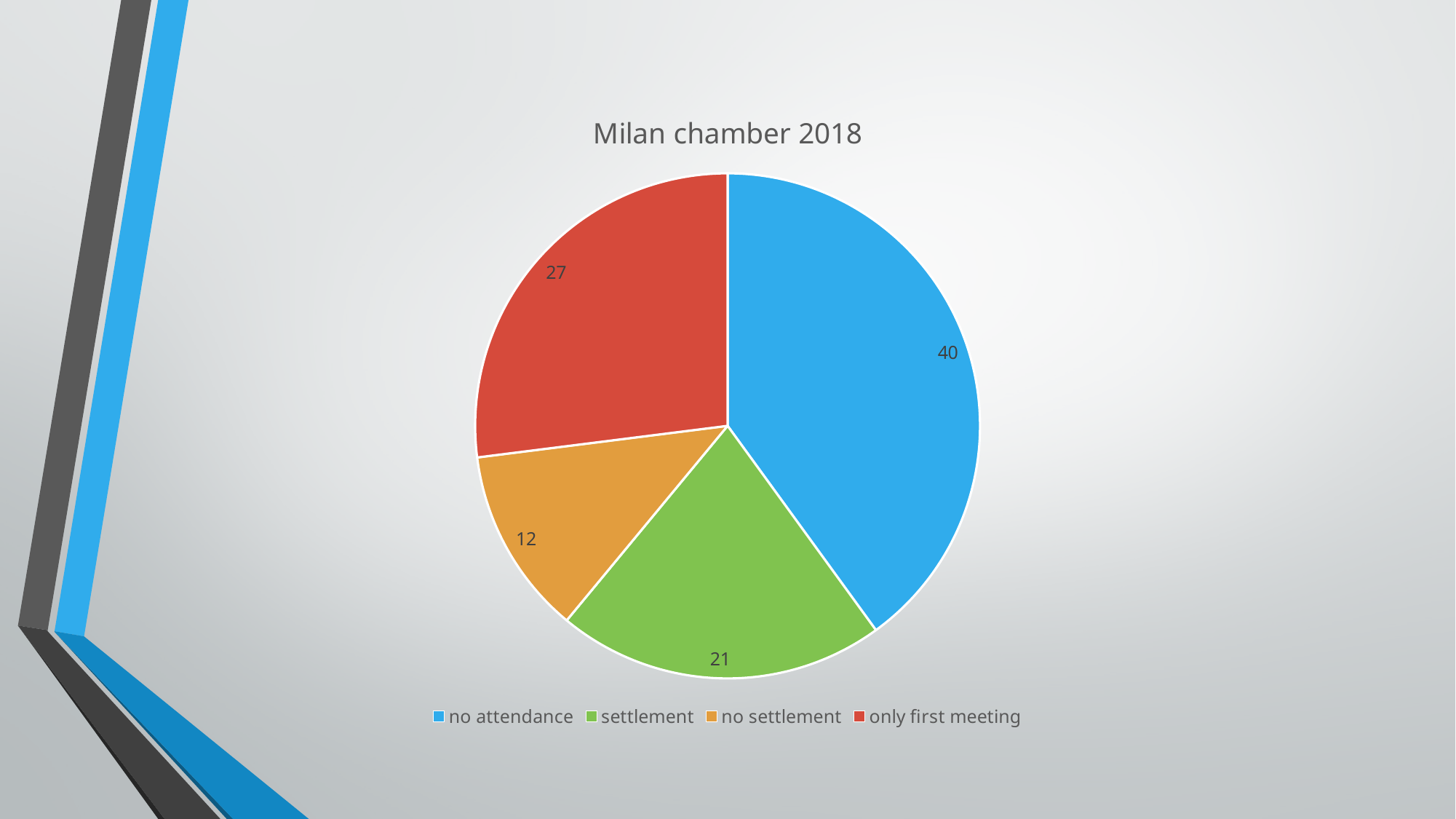
How many slices does the pie chart have? 4 What share of the pie does 'no attendance' represent? 40% Which category has the largest slice? no attendance Which is larger, 'settlement' or 'no settlement'? settlement What is the title of the chart? Milan chamber 2018 What is the difference between the values for 'no attendance' and 'only first meeting'? 13 Which category has the smallest slice? no settlement What is the value for 'no attendance'? 40 What kind of chart is shown on the slide? pie chart What is the value for 'no settlement'? 12 What is the value for 'settlement'? 21 What is the value for 'only first meeting'? 27